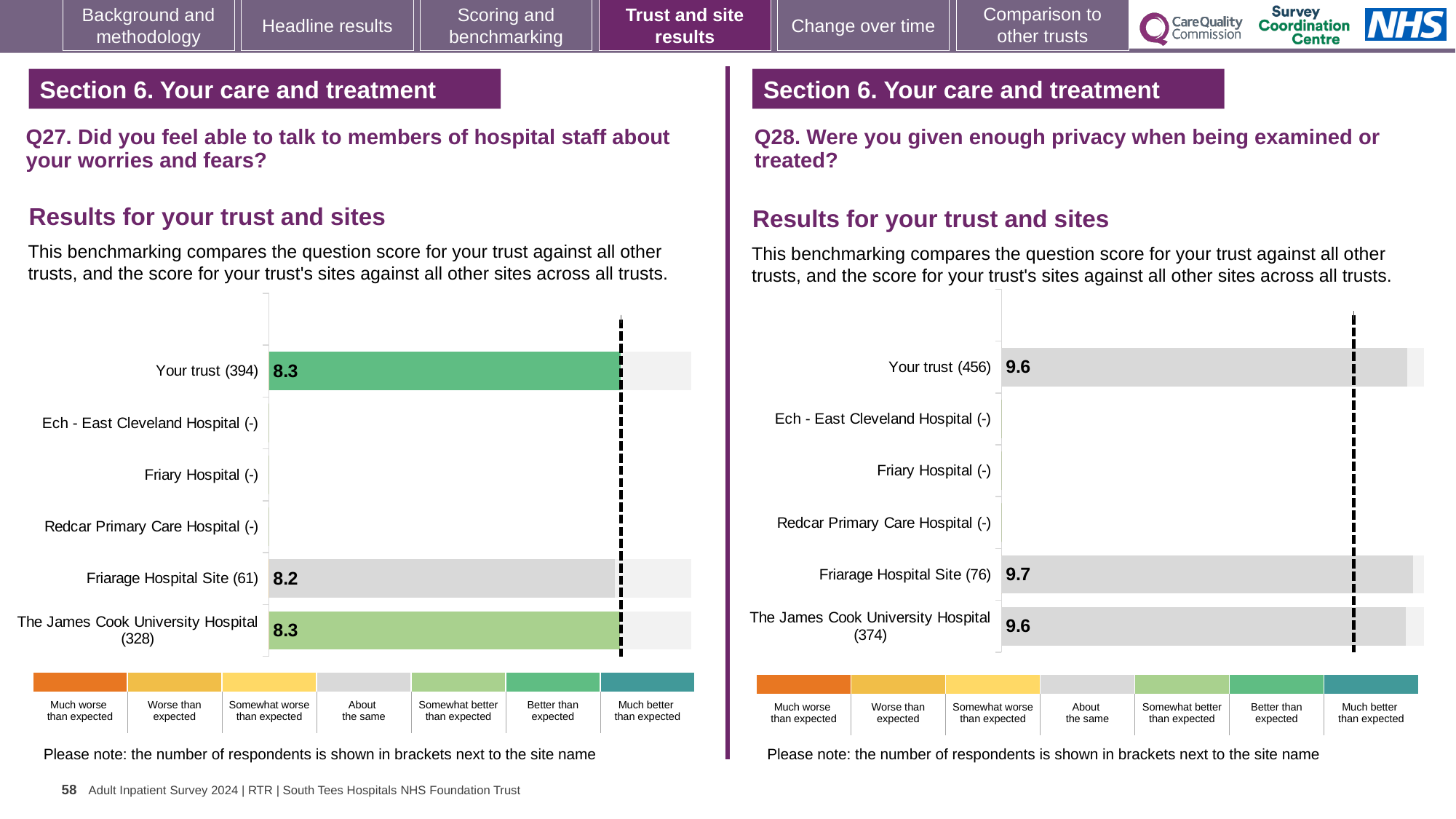
In the Q28 chart on the right, which site has the highest score? Friarage Hospital Site In the Q27 chart on the left, what is the score for Friarage Hospital Site (61)? 8.2 In the Q27 chart on the left, what is the score for The James Cook University Hospital (328)? 8.3 In the Q27 chart on the left, what is the difference between the scores for Your trust and Friarage Hospital Site? 0.1 What kind of chart is the Q28 chart on the right? Bar chart In the Q27 chart on the left, what is the score for Your trust (394)? 8.3 In the Q28 chart on the right, what is the score for Friarage Hospital Site (76)? 9.7 In the Q28 chart on the right, what is the score for Your trust (456)? 9.6 How many site or trust categories are listed on the y axis of the Q27 chart on the left? 6 In the Q28 chart on the right, what is the score for The James Cook University Hospital (374)? 9.6 In the Q27 chart on the left, which has the lower score, Friarage Hospital Site or The James Cook University Hospital? Friarage Hospital Site In the Q28 chart on the right, what is the difference between the scores for Friarage Hospital Site and The James Cook University Hospital? 0.1